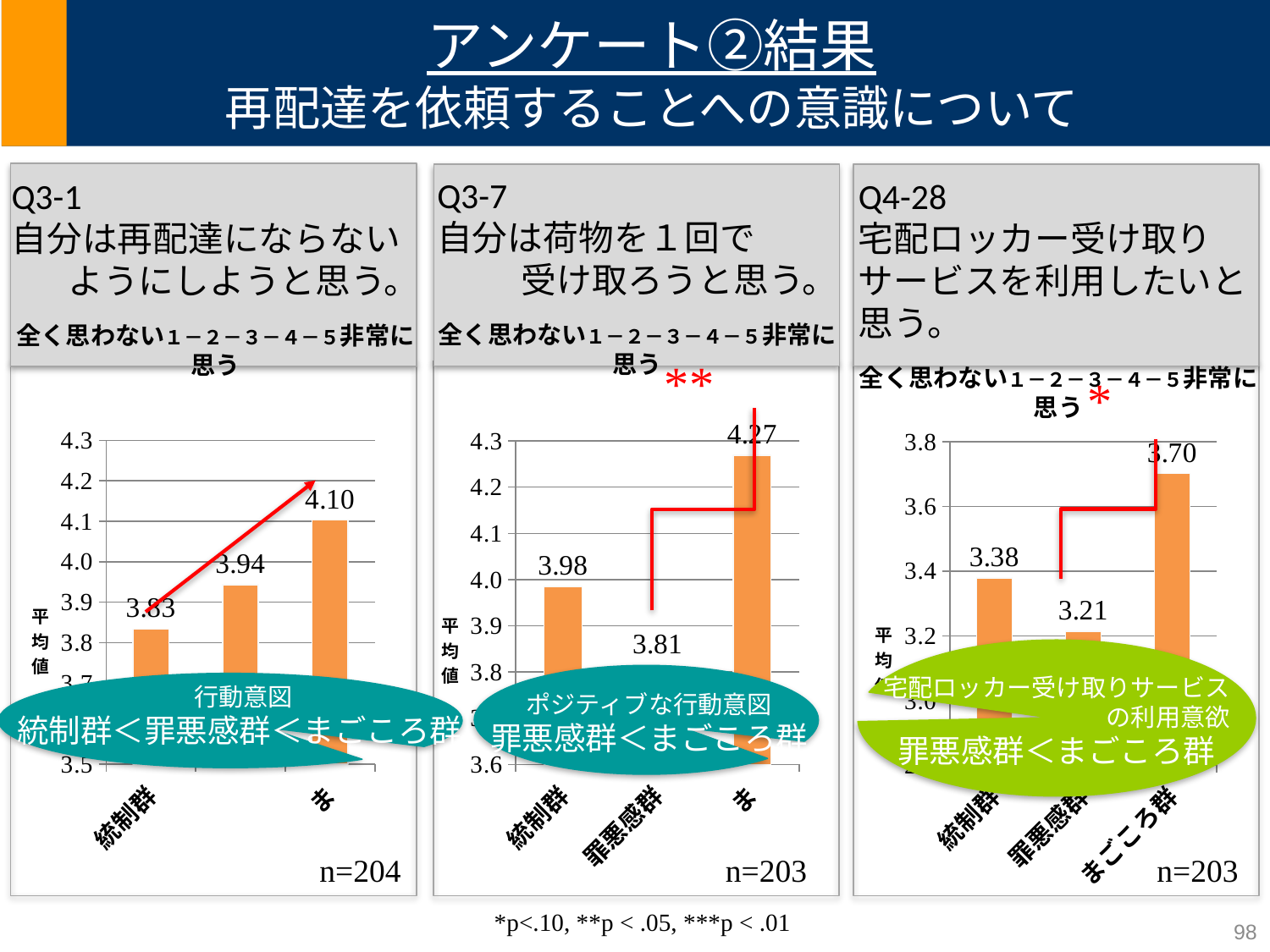
How many bars are plotted in the Q4-28 chart? 3 In the Q4-28 chart, which group has the highest value? まごころ群 What is the sample size (n) shown for the Q3-1 chart? n=204 In the Q3-7 chart, which is larger, the value for 統制群 or the value for 罪悪感群? 統制群 In the Q4-28 chart, what is the difference between the values for 統制群 and 罪悪感群? 0.17 In the Q3-7 chart, what is the value for 統制群? 3.98 In the Q4-28 chart, what is the value for 罪悪感群? 3.21 What kind of chart is the Q3-1 chart? bar chart In the Q4-28 chart, what is the value for まごころ群? 3.70 In the Q3-7 chart, which group has the lowest value? 罪悪感群 In the Q3-1 chart, what is the value for 統制群? 3.83 In the Q3-7 chart, what is the value for 罪悪感群? 3.81